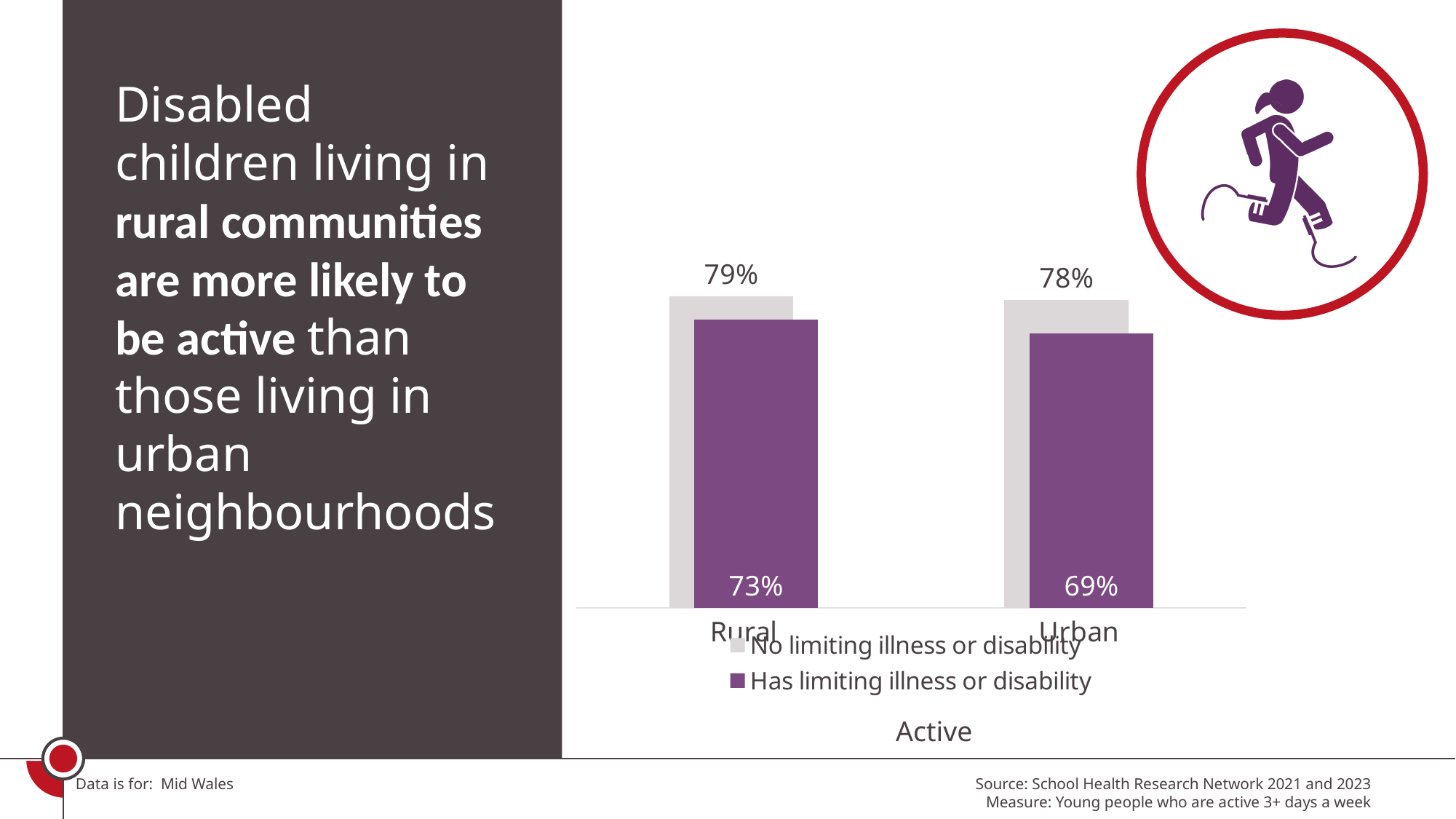
What is the value for 'No limiting illness or disability' in the Urban category? 78% What is the difference between the Rural and Urban values for 'Has limiting illness or disability'? 4 percentage points What is the value for 'No limiting illness or disability' in the Rural category? 79% How many series does the chart legend list? 2 How many categories are shown on the x axis of the chart? 2 What type of chart is shown on the slide? bar chart What percentage of children with a limiting illness or disability in urban areas are active? 69% In the Urban category, what is the difference between the 'No limiting illness or disability' and 'Has limiting illness or disability' values? 9 percentage points Which category has the lower value for 'Has limiting illness or disability', Rural or Urban? Urban In the Rural category, what is the difference between the 'No limiting illness or disability' and 'Has limiting illness or disability' values? 6 percentage points What percentage of children with a limiting illness or disability in rural areas are active? 73% Is the Rural value for 'Has limiting illness or disability' larger or smaller than the Urban value for the same series? larger